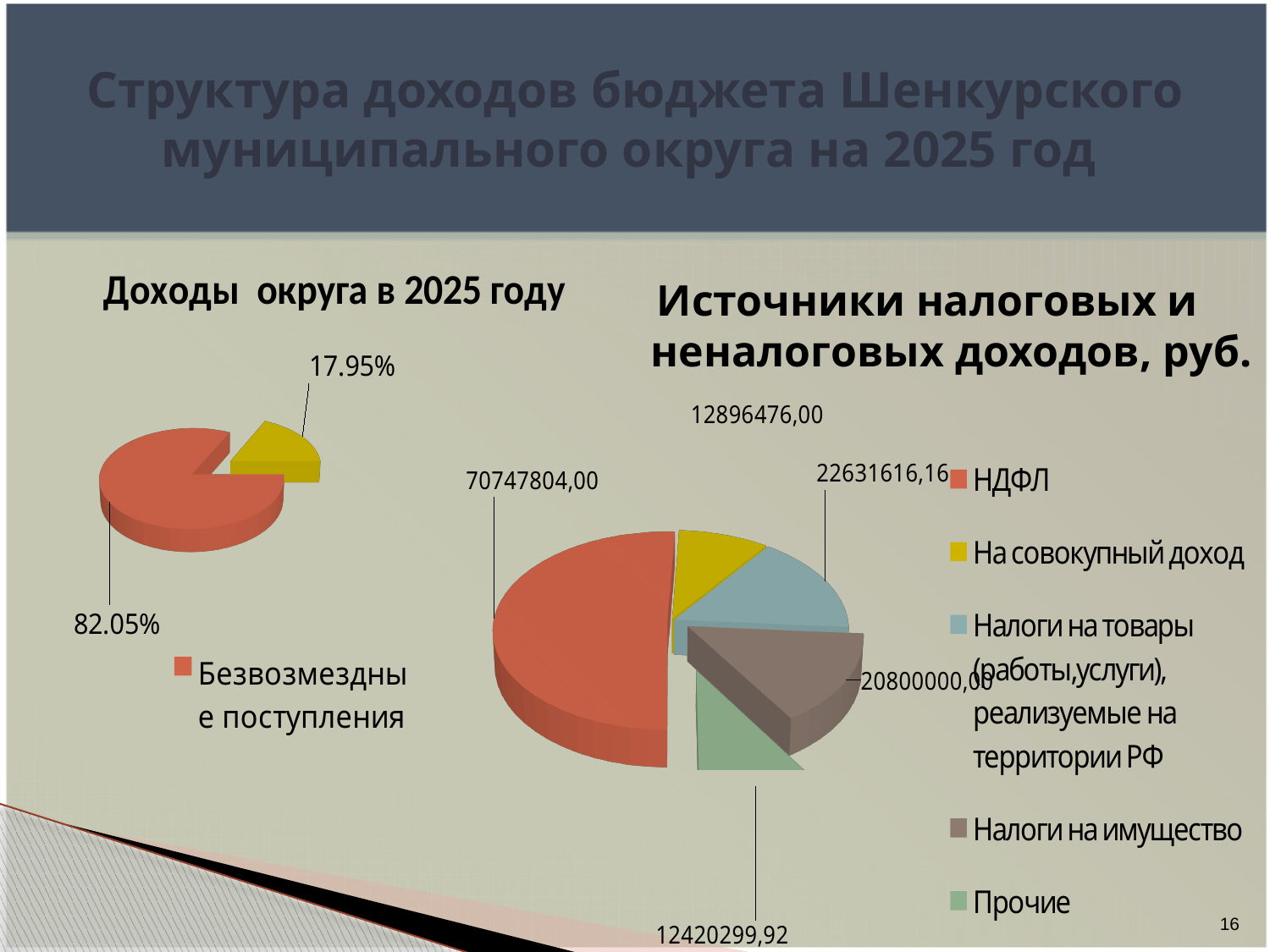
In the chart "Источники налоговых и неналоговых доходов, руб.", what is the value for НДФЛ? 70747804,00 How many categories does the legend of the chart "Источники налоговых и неналоговых доходов, руб." list? 5 What kind of chart is "Доходы округа в 2025 году"? Pie chart In the chart "Источники налоговых и неналоговых доходов, руб.", what is the value for "На совокупный доход"? 12896476,00 In the chart titled "Доходы округа в 2025 году", what share of the pie does "Безвозмездные поступления" take? 82.05% In the chart "Источники налоговых и неналоговых доходов, руб.", which category has the smallest value? Прочие In the chart "Источники налоговых и неналоговых доходов, руб.", which is larger: "Налоги на товары (работы,услуги), реализуемые на территории РФ" or "Налоги на имущество"? Налоги на товары (работы,услуги), реализуемые на территории РФ In the chart "Источники налоговых и неналоговых доходов, руб.", what is the difference between the value for "Налоги на товары (работы,услуги), реализуемые на территории РФ" and the value for "Налоги на имущество"? 1831616,16 In the chart "Источники налоговых и неналоговых доходов, руб.", which category has the largest value? НДФЛ In the chart "Источники налоговых и неналоговых доходов, руб.", what is the value for "Налоги на имущество"? 20800000,00 In the chart titled "Доходы округа в 2025 году", what is the value shown for the smaller (yellow) slice? 17.95% In the chart "Источники налоговых и неналоговых доходов, руб.", what is the value for "Прочие"? 12420299,92